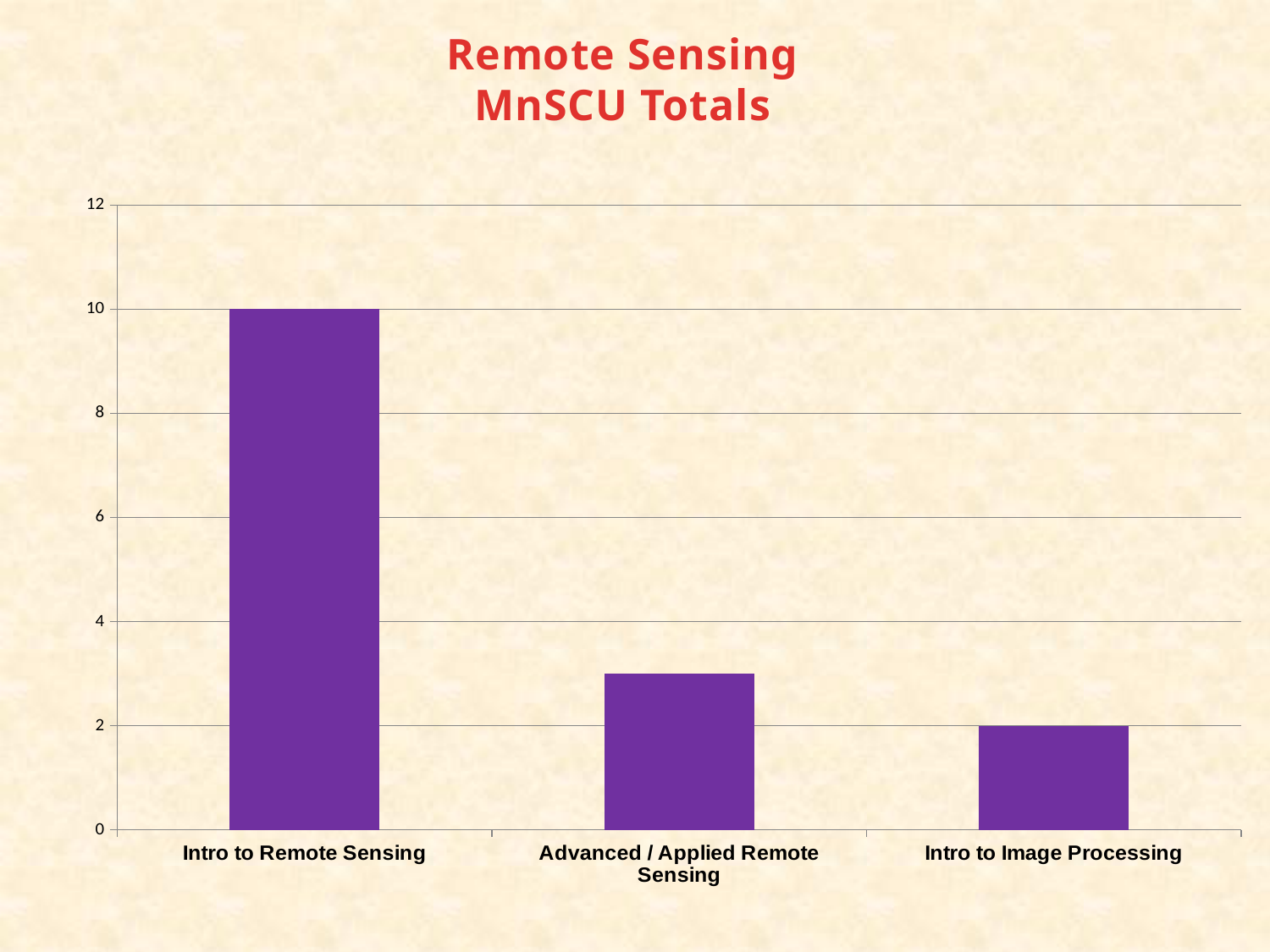
What is the value for Intro to Remote Sensing? 10 Which category has the lowest value? Intro to Image Processing What is the difference between the values for Intro to Remote Sensing and Intro to Image Processing? 8 Is the value for Advanced / Applied Remote Sensing greater or less than 4? less Which is larger, the value for Advanced / Applied Remote Sensing or the value for Intro to Image Processing? Advanced / Applied Remote Sensing What kind of chart is shown on the slide? bar chart Do the values rise or fall from left to right along the x axis? fall What is the value for Intro to Image Processing? 2 Which category has the highest value? Intro to Remote Sensing How many categories are shown on the x axis? 3 What is the title of the chart? Remote Sensing MnSCU Totals Is the value for Advanced / Applied Remote Sensing greater or less than 2? greater